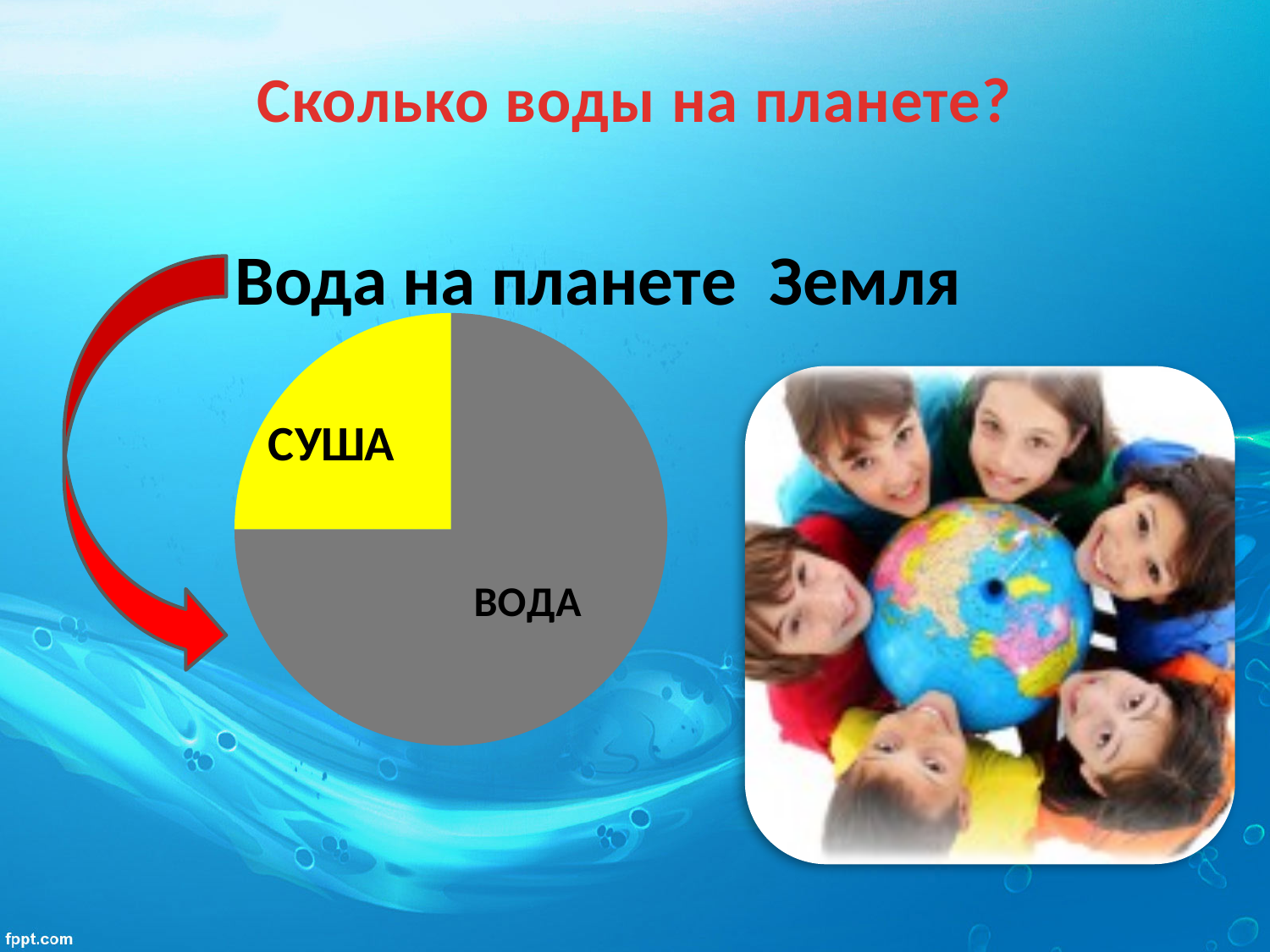
Does the ВОДА slice take up more or less than half of the pie? more Which slice is larger, СУША or ВОДА? ВОДА Which slice of the pie chart is the smallest? СУША How many slices does the pie chart have? 2 What colour is the СУША slice in the pie chart? yellow What kind of chart is shown on the slide? pie chart What is the title of the pie chart? Вода на планете Земля Which slice of the pie chart is the largest? ВОДА